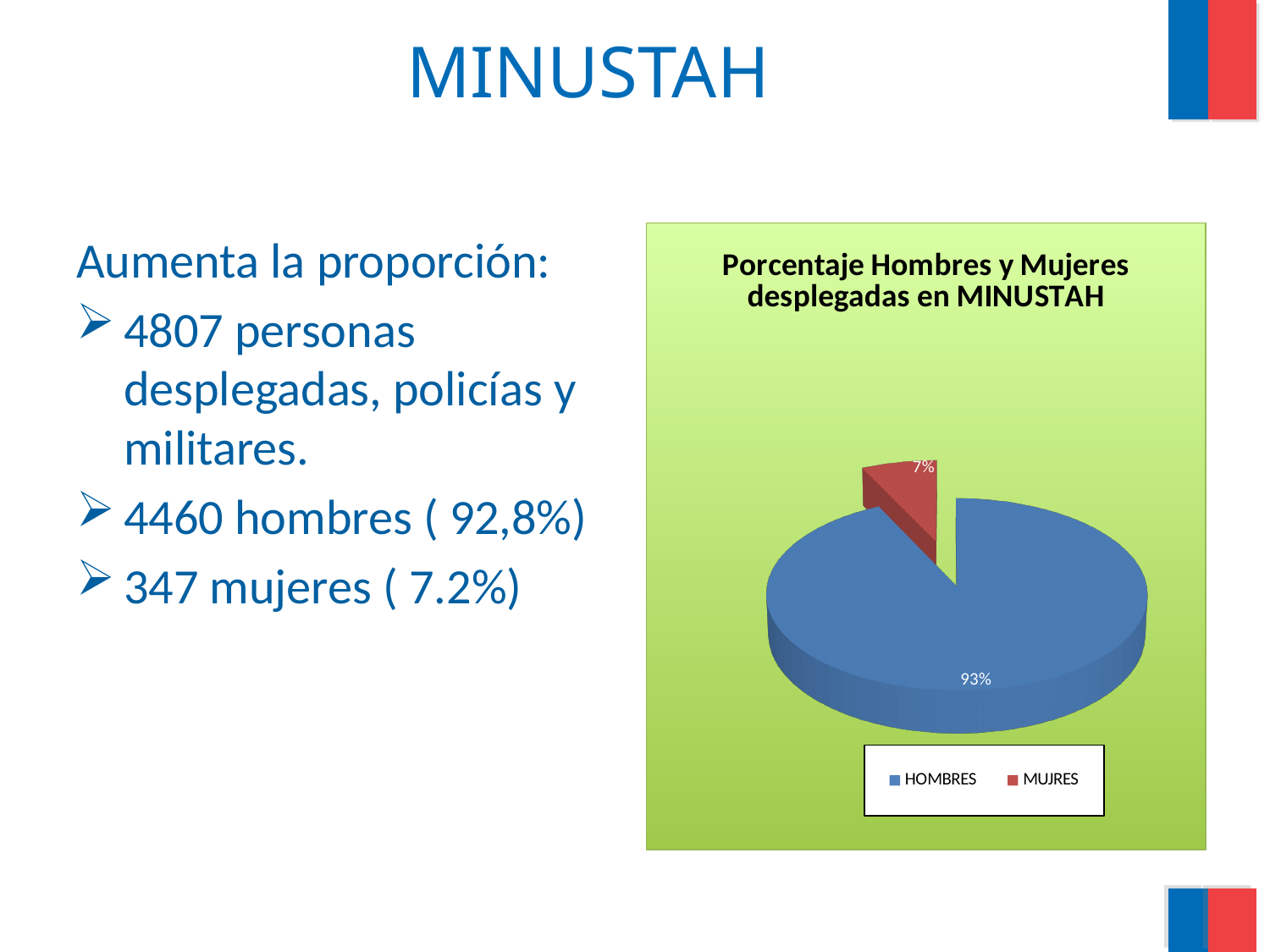
How many slices does the pie chart have? 2 What is the chart's title? Porcentaje Hombres y Mujeres desplegadas en MINUSTAH Which slice is the smallest? MUJRES What percentage does the MUJRES slice show? 7% What colour is the HOMBRES slice? blue Which is larger, the HOMBRES slice or the MUJRES slice? HOMBRES How many entries does the legend list? 2 What is the difference in percentage points between the HOMBRES and MUJRES slices? 86 What share of the pie does the MUJRES slice represent? 7% What kind of chart is shown on the slide? pie chart What percentage does the HOMBRES slice show? 93% Which slice is the largest? HOMBRES